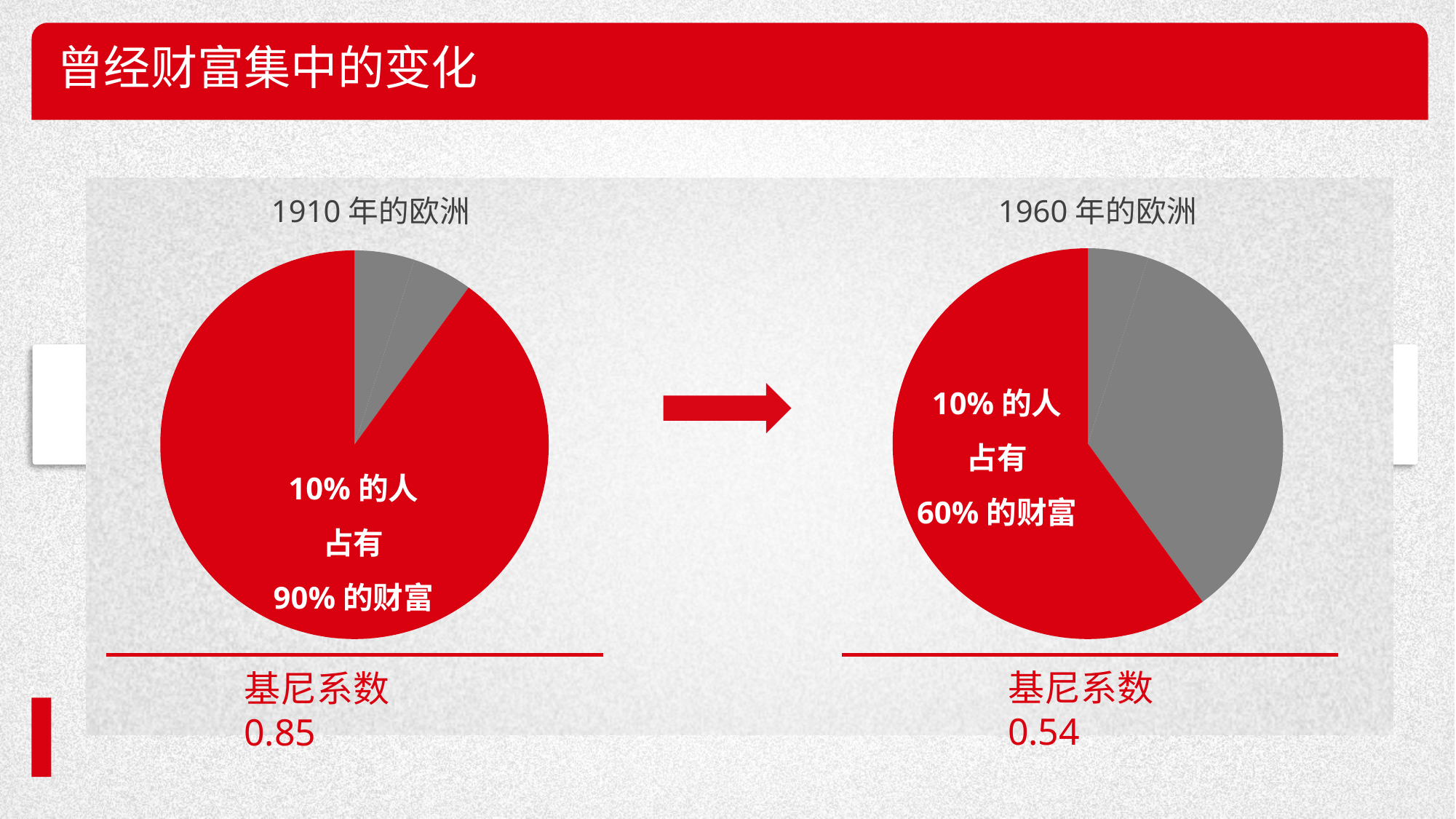
By how many percentage points does the wealth share of the top 10% differ between the 1910 年的欧洲 chart and the 1960 年的欧洲 chart? 30 percentage points In the 1960 年的欧洲 chart, what share of the pie is the grey slice? 40% What is the title of the chart on the left of the slide? 1910 年的欧洲 In the 1910 年的欧洲 chart, what share of wealth is held by 10% of the people? 90% From the 1910 年的欧洲 chart to the 1960 年的欧洲 chart, does the share of wealth held by 10% of the people rise or fall? Fall In the 1960 年的欧洲 chart, what share of wealth is held by 10% of the people? 60% In the 1960 年的欧洲 chart, which colour represents the wealth held by 10% of the people? Red How many slices does the 1960 年的欧洲 pie chart have? 3 What kind of chart is used for the 1910 年的欧洲 chart? Pie chart In the 1910 年的欧洲 chart, what share of the pie is the grey slice? 10% Which chart shows a larger red slice, 1910 年的欧洲 or 1960 年的欧洲? 1910 年的欧洲